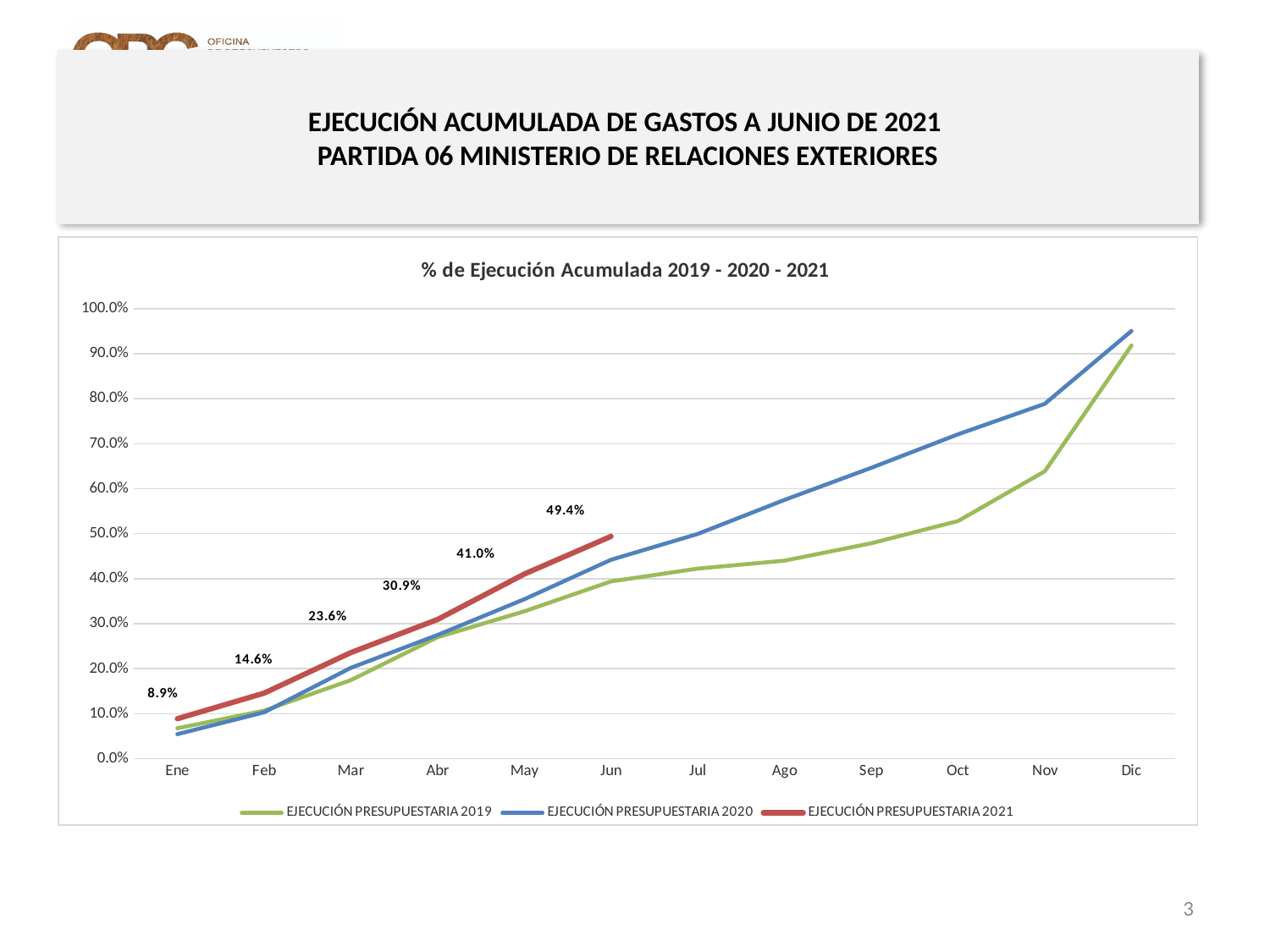
In Nov, which series has the larger value, EJECUCIÓN PRESUPUESTARIA 2019 or EJECUCIÓN PRESUPUESTARIA 2020? EJECUCIÓN PRESUPUESTARIA 2020 What kind of chart is shown? Line chart How many series does the legend list? 3 Which month has the highest labelled value for EJECUCIÓN PRESUPUESTARIA 2021? Jun Is the value for EJECUCIÓN PRESUPUESTARIA 2020 in Dic greater or less than 90.0%? greater What is the value of EJECUCIÓN PRESUPUESTARIA 2021 for Jun? 49.4% How many months are shown on the x axis? 12 Do the values of EJECUCIÓN PRESUPUESTARIA 2020 rise or fall from Ene to Dic? Rise By how much did EJECUCIÓN PRESUPUESTARIA 2021 increase from May to Jun? 8.4% What is the value of EJECUCIÓN PRESUPUESTARIA 2021 for Abr? 30.9% What is the value of EJECUCIÓN PRESUPUESTARIA 2021 for Ene? 8.9% What is the value of EJECUCIÓN PRESUPUESTARIA 2021 for Mar? 23.6%